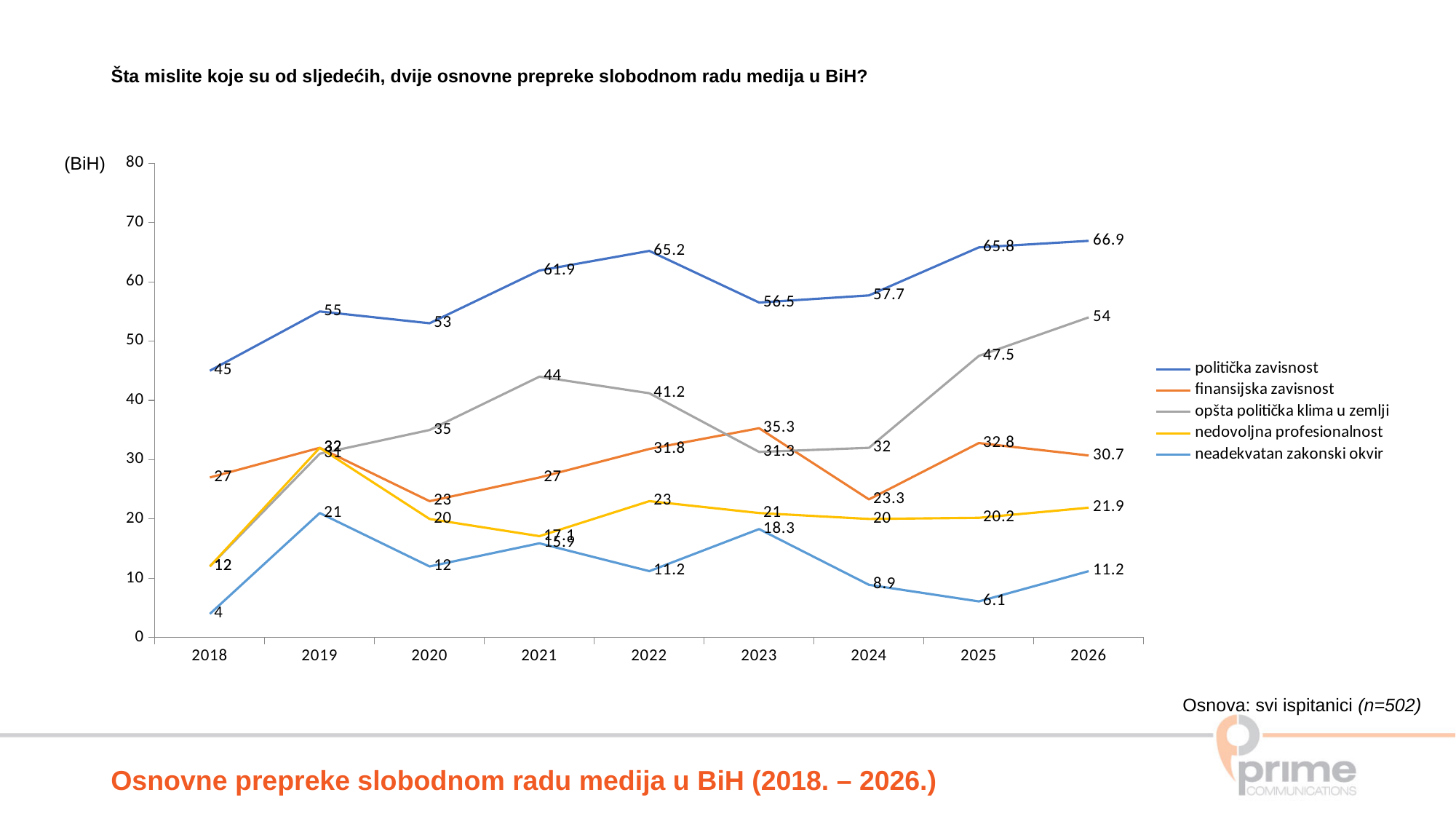
What is the value for opšta politička klima u zemlji in 2025? 47.5 How many series does the legend list? 5 What kind of chart is shown on the slide? line chart In 2023, which is larger: finansijska zavisnost or opšta politička klima u zemlji? finansijska zavisnost How many years are shown on the x axis? 9 Is the value for opšta politička klima u zemlji in 2021 greater or less than 40? greater In which year is politička zavisnost at its highest? 2026 What is the value for nedovoljna profesionalnost in 2021? 17.1 In which year is neadekvatan zakonski okvir at its lowest? 2018 By how much did politička zavisnost increase from 2018 to 2026? 21.9 What is the value for politička zavisnost in 2026? 66.9 What is the value for neadekvatan zakonski okvir in 2024? 8.9